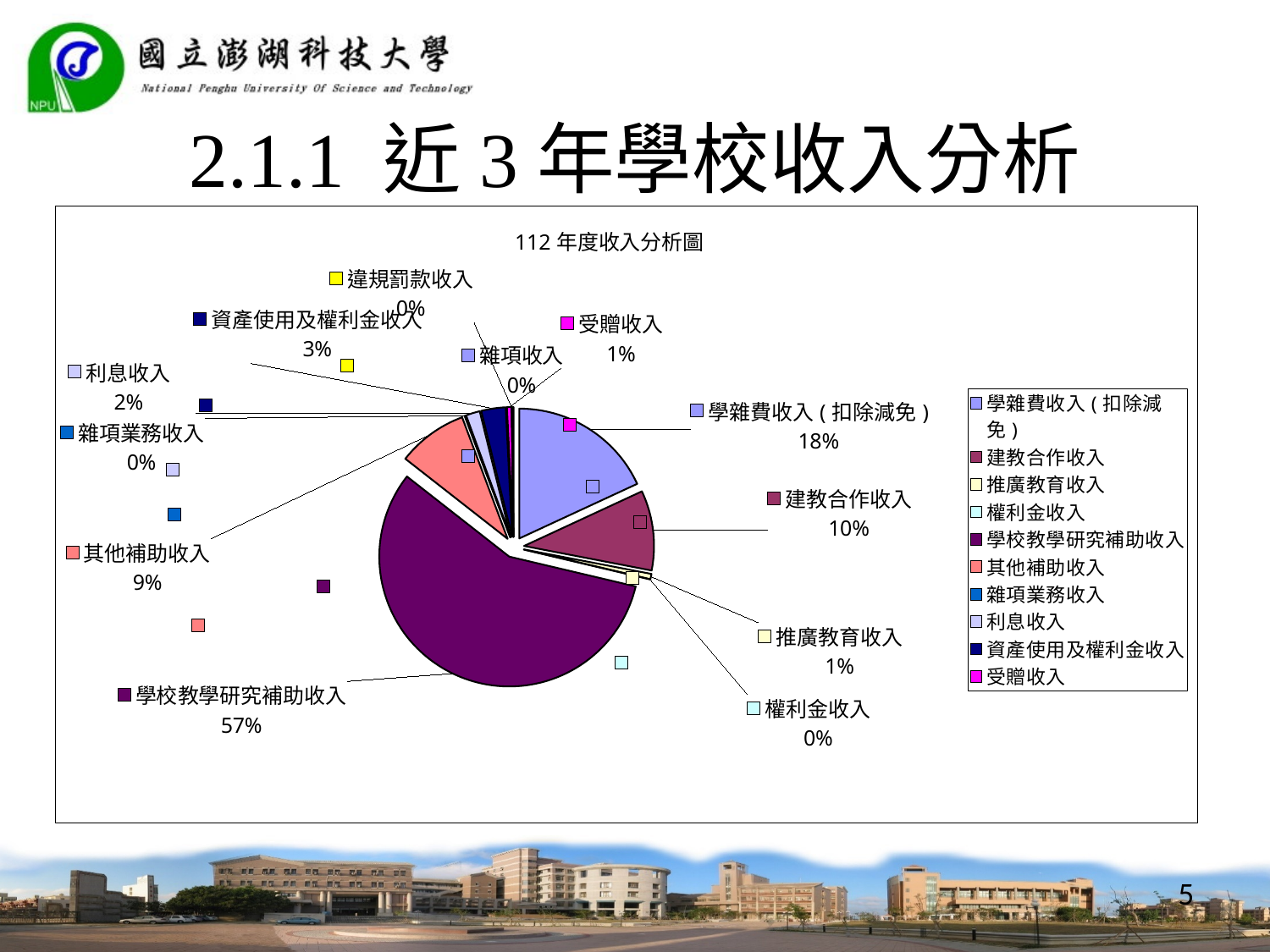
What is the percentage shown for 利息收入? 2% Which category has the largest share of the pie? 學校教學研究補助收入 What share of the pie does 學雜費收入（扣除減免）represent? 18% What is the title of the chart? 112 年度收入分析圖 What is the difference in percentage points between 學校教學研究補助收入 and 學雜費收入（扣除減免）? 39 What share of the pie does 學校教學研究補助收入 represent? 57% What is the percentage shown for 資產使用及權利金收入? 3% How many entries does the legend on the right list? 10 What type of chart is shown on the slide? pie chart What is the percentage shown for 建教合作收入? 10% Which is larger, the share for 學雜費收入（扣除減免）or the share for 建教合作收入? 學雜費收入（扣除減免） What is the percentage shown for 其他補助收入? 9%